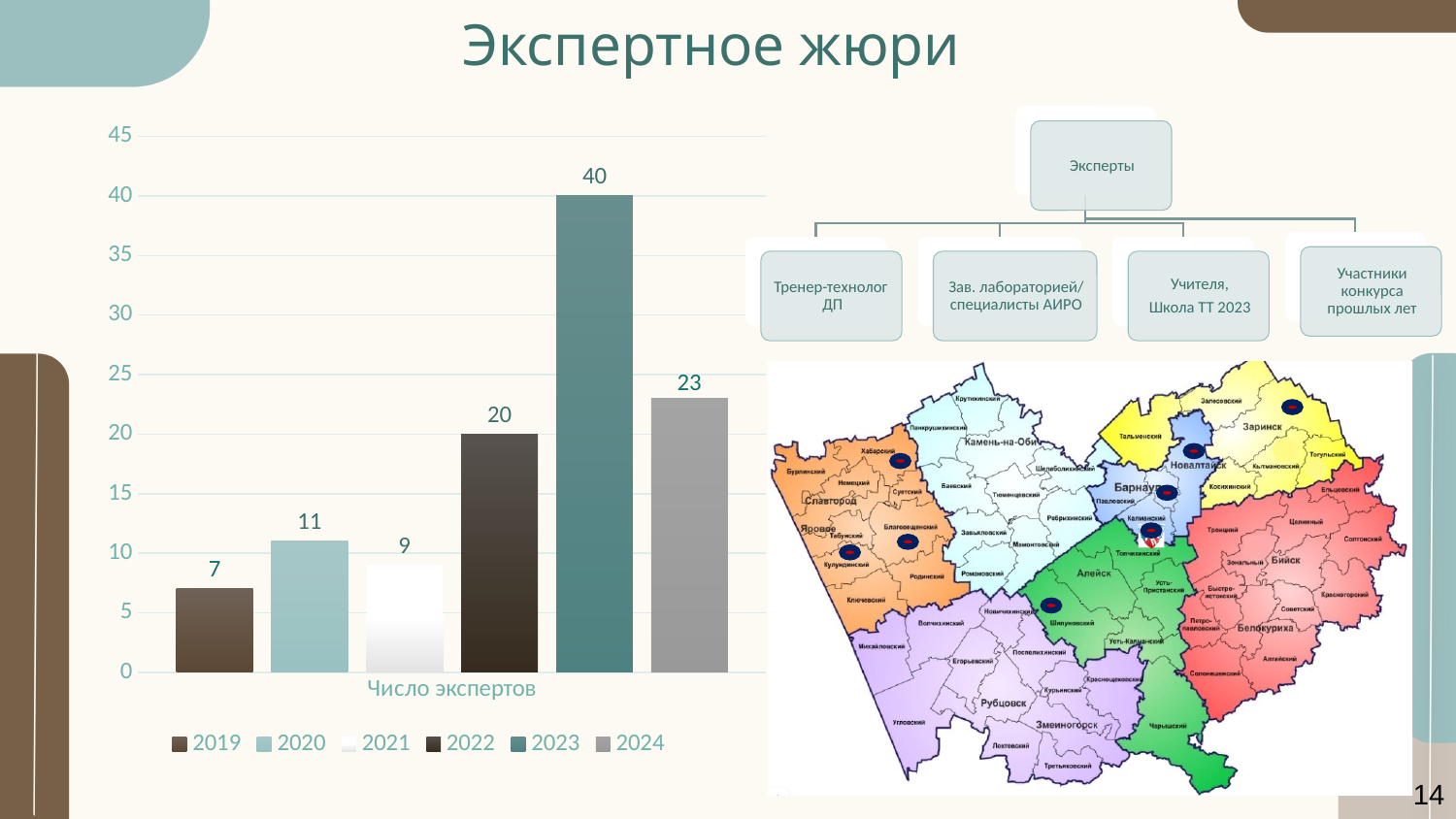
Which year has the highest number of experts? 2023 What is the difference between the number of experts in 2023 and 2022? 20 What is the label shown on the category axis of the chart? Число экспертов What is the difference between the number of experts in 2020 and 2021? 2 Which is larger, the number of experts in 2024 or in 2022? 2024 What is the number of experts for 2019? 7 What kind of chart is shown on the slide? bar chart Is the value for 2022 greater or less than 15? greater What is the number of experts for 2024? 23 How many series does the legend list? 6 What is the number of experts for 2023? 40 Which year has the lowest number of experts? 2019